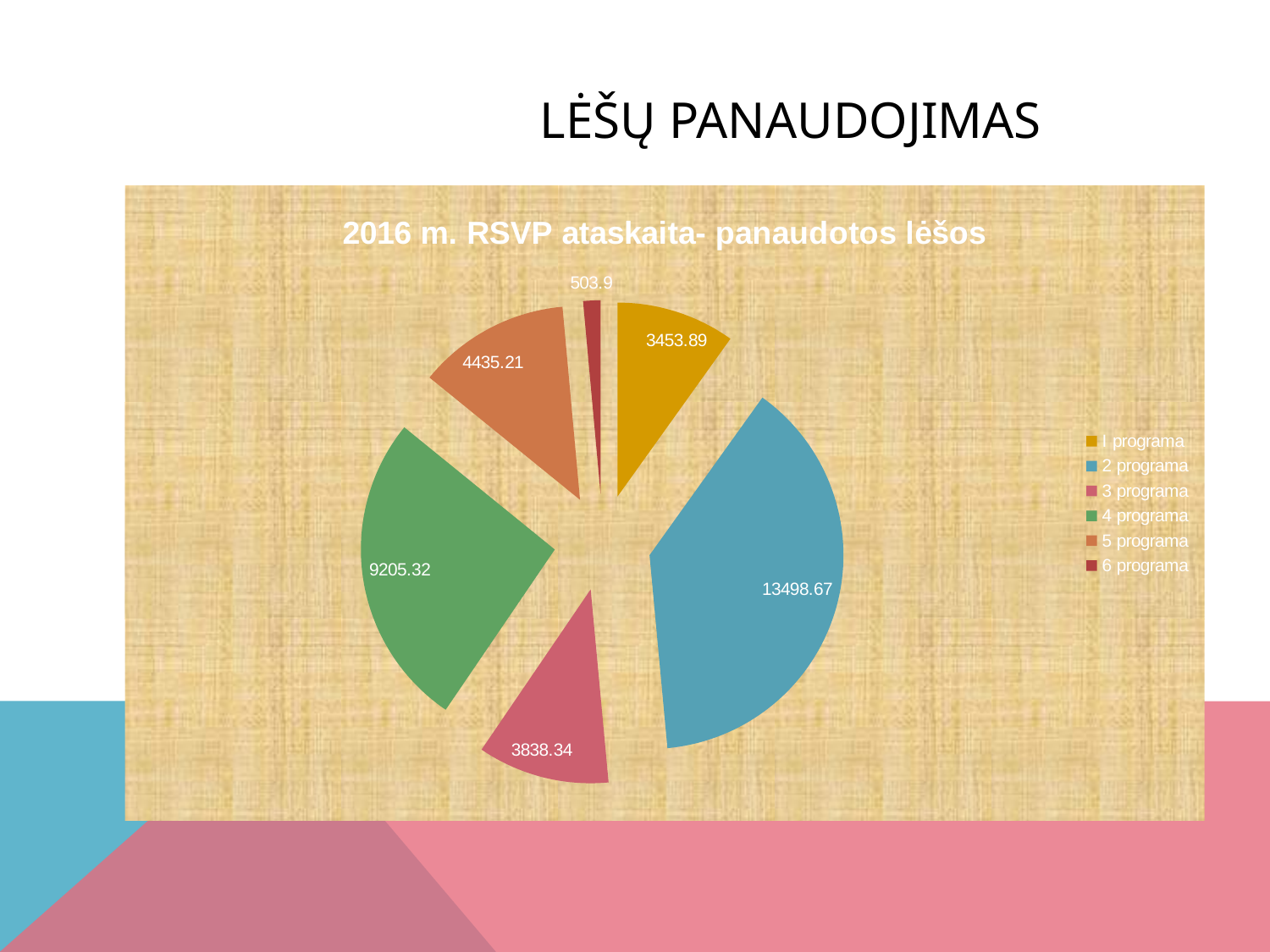
How many series does the legend list? 6 Which programa has the smallest slice? 6 programa What is the title of the chart? 2016 m. RSVP ataskaita- panaudotos lėšos What is the value for 6 programa? 503.9 What is the value for 2 programa? 13498.67 What is the difference between the values for 2 programa and 4 programa? 4293.35 Which is larger, the value for 5 programa or the value for 3 programa? 5 programa What is the value for 5 programa? 4435.21 What is the value for 4 programa? 9205.32 What type of chart is shown on the slide? pie chart What colour is the slice for 4 programa? green Which programa has the largest slice? 2 programa